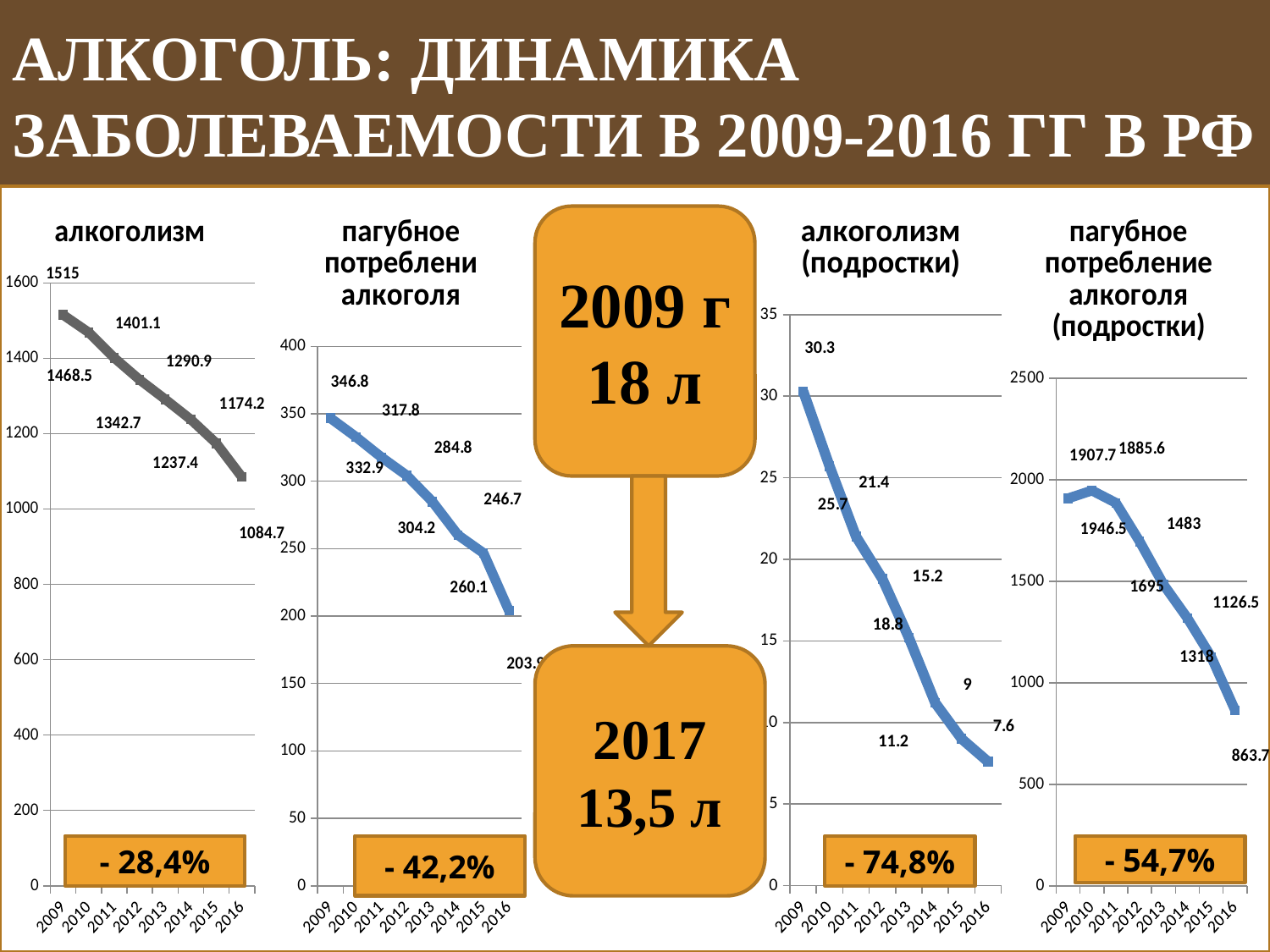
In the chart titled "алкоголизм", what is the value for 2009? 1515 In the chart titled "пагубное потребление алкоголя (подростки)", which year has the highest value? 2010 In the chart titled "пагубное потреблени алкоголя", is the value for 2014 greater or less than 250? greater In the chart titled "алкоголизм", do the values rise or fall from 2009 to 2016? fall In the chart titled "алкоголизм (подростки)", what is the value for 2015? 9 In the chart titled "алкоголизм (подростки)", what is the difference between the values for 2009 and 2016? 22.7 In the chart titled "алкоголизм", what is the value for 2016? 1084.7 In the chart titled "пагубное потреблени алкоголя", what is the value for 2013? 284.8 In the chart titled "пагубное потребление алкоголя (подростки)", which is larger, the value for 2009 or the value for 2010? 2010 In the chart titled "алкоголизм (подростки)", which year has the lowest value? 2016 How many years are plotted in the chart titled "алкоголизм"? 8 What kind of chart is the chart titled "алкоголизм (подростки)"? line chart